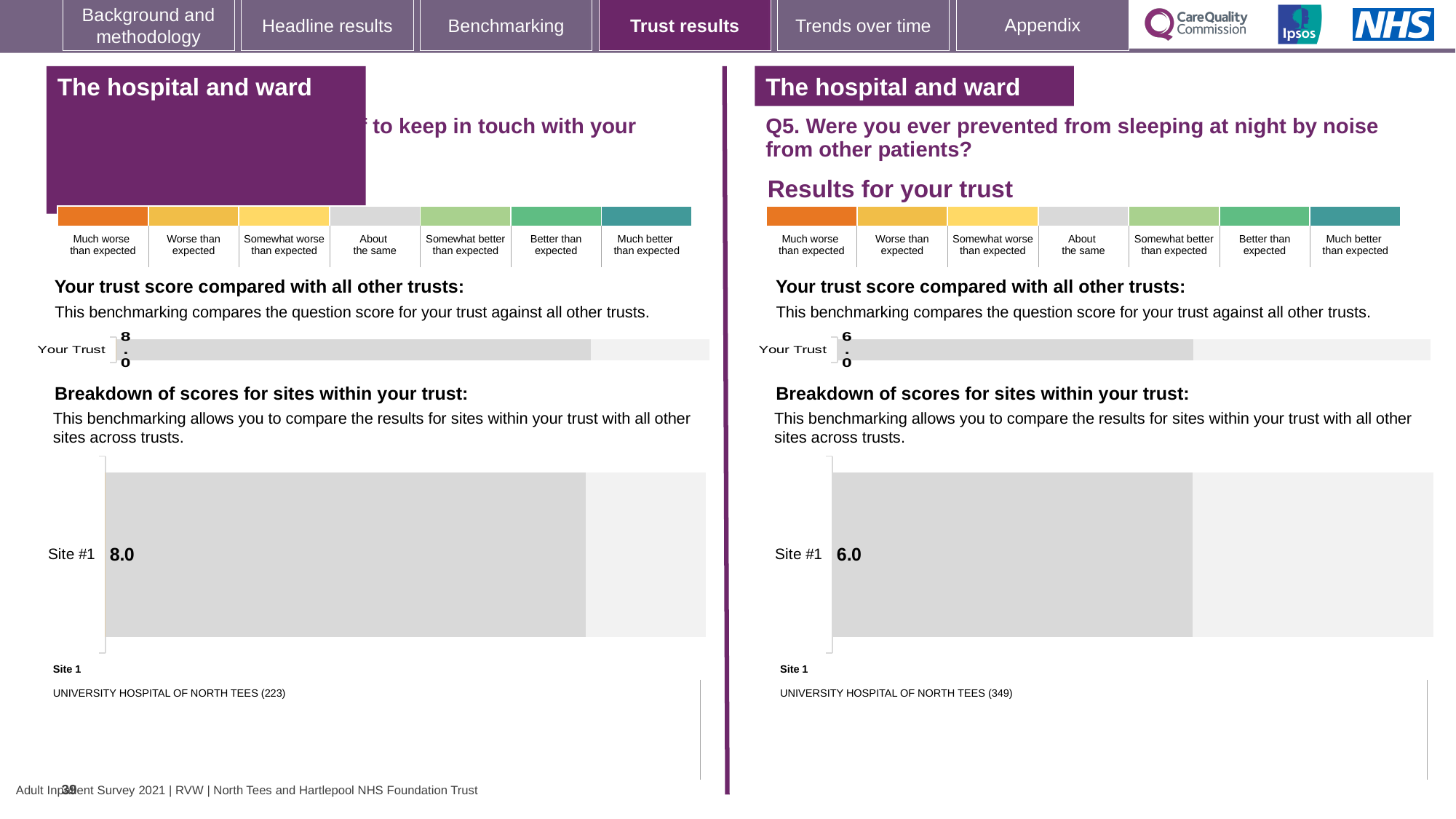
What kind of chart is used to show the Site #1 score on the right-hand side of the slide? bar chart On the left-hand side of the slide, which site is listed as Site 1? UNIVERSITY HOSPITAL OF NORTH TEES (223) On the right-hand side of the slide (Q5), is the Your Trust score the same as the Site #1 score? Yes, both are 6.0 On the right-hand side of the slide (Q5), what is the score shown for Your Trust? 6.0 On the left-hand side of the slide, what is the score shown for Site #1? 8.0 On the left-hand side of the slide, what is the score shown for Your Trust? 8.0 On the right-hand side of the slide (Q5), which site is listed as Site 1? UNIVERSITY HOSPITAL OF NORTH TEES (349) On the right-hand side of the slide (Q5), what is the score shown for Site #1? 6.0 Which is larger: the Site #1 score on the left-hand side of the slide or the Site #1 score on the right-hand side (Q5)? Left-hand side (8.0) How many sites are shown in the 'Breakdown of scores for sites within your trust' chart on the right-hand side of the slide? 1 What is the difference between the Site #1 score on the left-hand side of the slide and the Site #1 score on the right-hand side (Q5)? 2.0 How many sites are shown in the 'Breakdown of scores for sites within your trust' chart on the left-hand side of the slide? 1